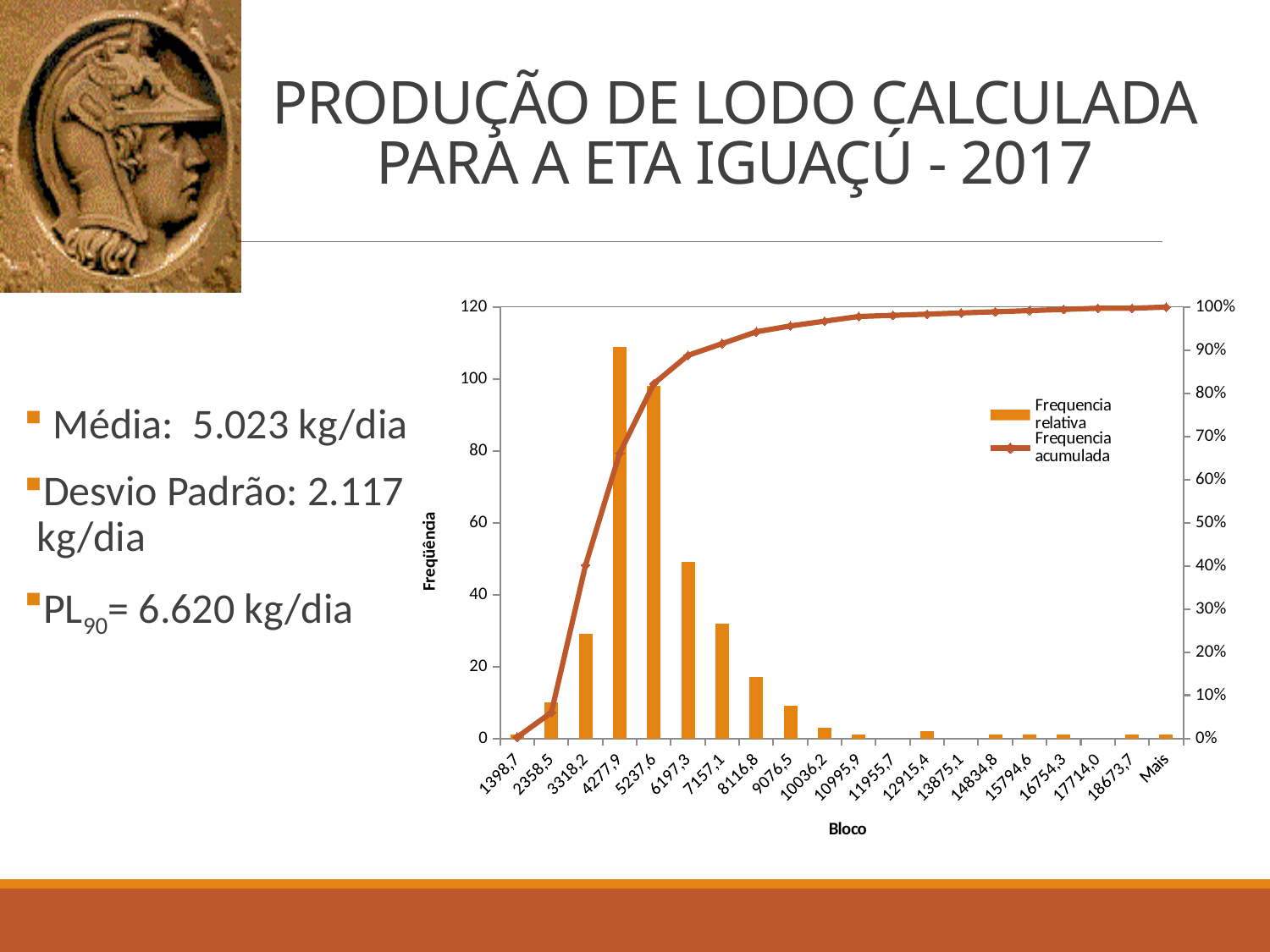
Is the Frequencia relativa value for 8116,8 greater or less than 20? less Does the Frequencia acumulada line rise or fall along the x axis? It rises Is the Frequencia relativa value for 5237,6 greater or less than 80? greater Which category has the highest Frequencia relativa bar? 4277,9 Is the Frequencia relativa value for 6197,3 greater or less than 60? less What kind of chart is shown on the slide? A combined bar and line chart What are the two series named in the chart legend? Frequencia relativa and Frequencia acumulada What is the title of the x axis of the chart? Bloco How many categories are shown along the x axis of the chart? 20 Which has a larger Frequencia relativa bar, 3318,2 or 6197,3? 6197,3 How many series does the chart legend list? 2